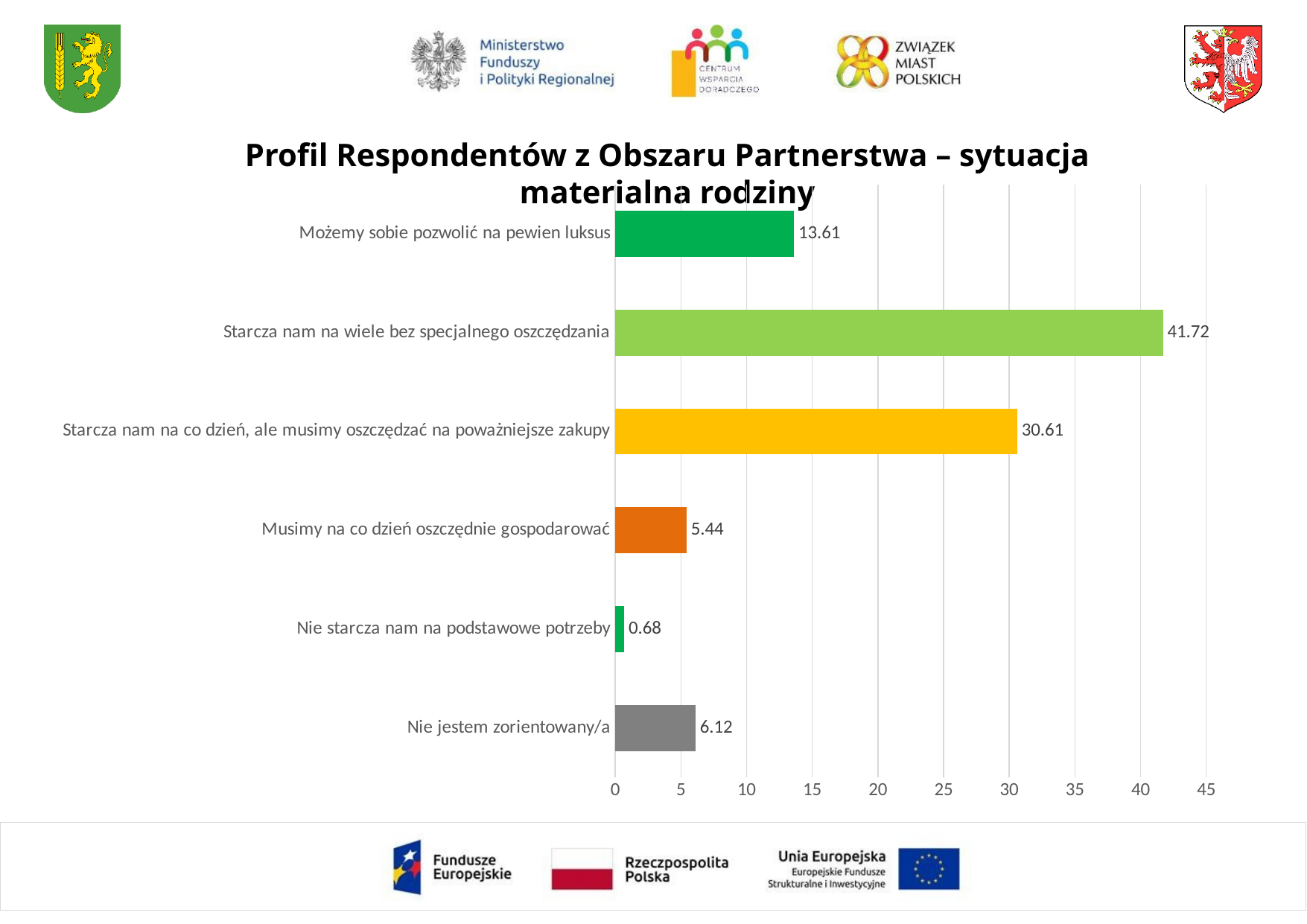
What is the value for "Starcza nam na wiele bez specjalnego oszczędzania"? 41.72 How many categories are shown in the chart? 6 What is the value for "Możemy sobie pozwolić na pewien luksus"? 13.61 Which is larger: the value for "Nie jestem zorientowany/a" or the value for "Musimy na co dzień oszczędnie gospodarować"? Nie jestem zorientowany/a Is the value for "Starcza nam na co dzień, ale musimy oszczędzać na poważniejsze zakupy" greater or less than 30? greater What is the difference between the values for "Starcza nam na wiele bez specjalnego oszczędzania" and "Starcza nam na co dzień, ale musimy oszczędzać na poważniejsze zakupy"? 11.11 What is the value for "Musimy na co dzień oszczędnie gospodarować"? 5.44 Which category has the highest value? Starcza nam na wiele bez specjalnego oszczędzania What is the title of the chart? Profil Respondentów z Obszaru Partnerstwa – sytuacja materialna rodziny Which category has the lowest value? Nie starcza nam na podstawowe potrzeby What is the value for "Nie jestem zorientowany/a"? 6.12 What kind of chart is shown on the slide? bar chart